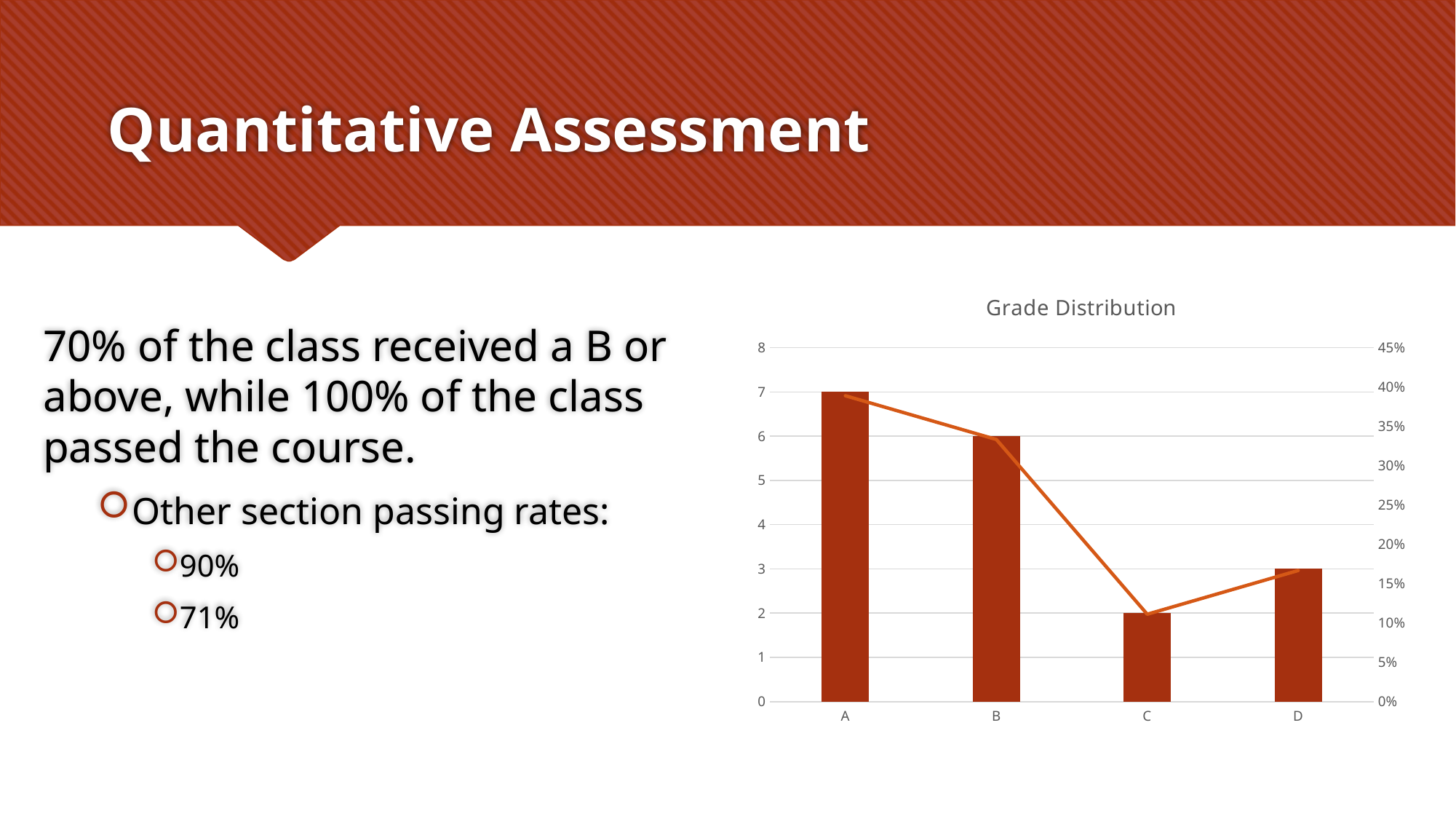
In the Grade Distribution chart, what is the difference between the bar values for grade A and grade C? 5 In the Grade Distribution chart, is the line value for grade C greater or less than 15% on the right-hand axis? less In the Grade Distribution chart, what is the bar value for grade B? 6 Do the bar values in the Grade Distribution chart rise or fall from grade A to grade C? fall In the Grade Distribution chart, what is the bar value for grade C? 2 In the Grade Distribution chart, which has the larger bar value, grade B or grade D? B What is the title of the chart on the slide? Grade Distribution In the Grade Distribution chart, which grade has the lowest bar? C In the Grade Distribution chart, which grade has the highest bar? A In the Grade Distribution chart, what is the bar value for grade A? 7 In the Grade Distribution chart, what is the bar value for grade D? 3 How many grade categories are shown on the x axis of the Grade Distribution chart? 4